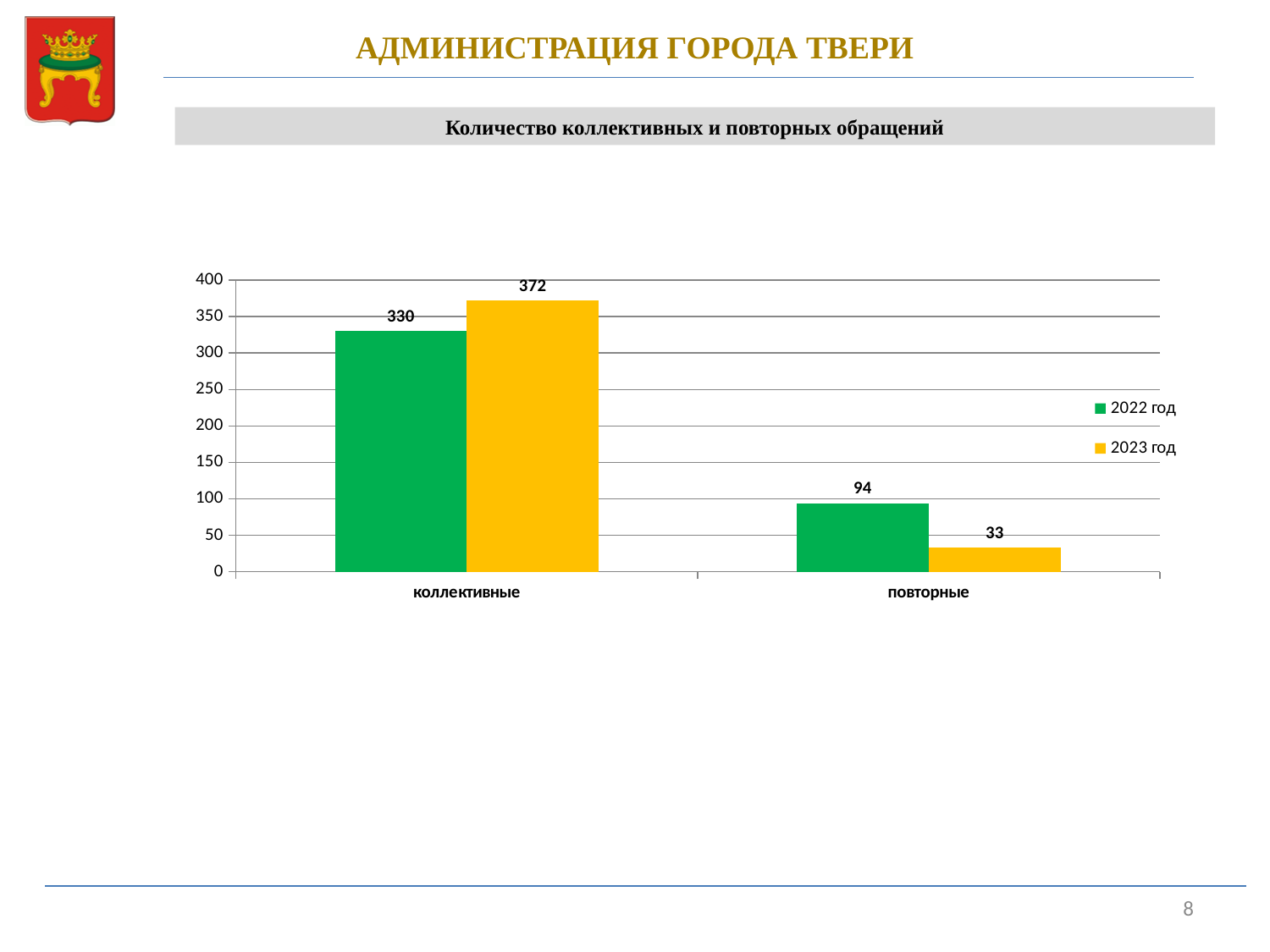
How many series does the legend list? 2 What is the difference between the 2022 год and 2023 год values for повторные? 61 Which is larger for повторные: the 2022 год value or the 2023 год value? 2022 год Which category has the lowest value in 2022 год? повторные What kind of chart is shown on the slide? bar chart What is the value for коллективные in 2022 год? 330 What is the difference between the 2023 год and 2022 год values for коллективные? 42 What is the title of the chart? Количество коллективных и повторных обращений What is the value for повторные in 2022 год? 94 What is the value for повторные in 2023 год? 33 What is the value for коллективные in 2023 год? 372 Which category has the highest value in 2023 год? коллективные